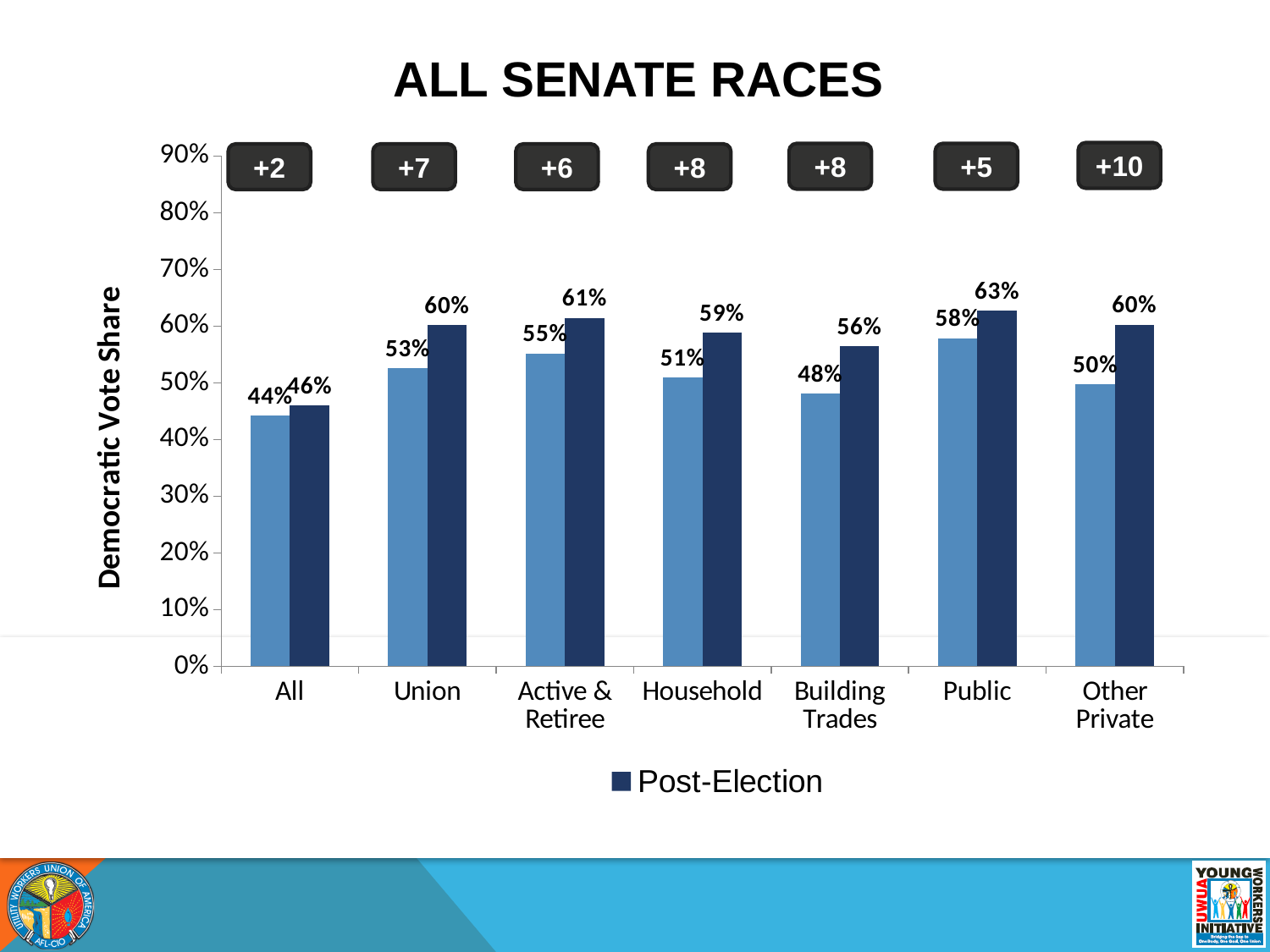
Which category has the highest Post-Election value? Public What value is shown on the lighter blue bar for Building Trades? 48% Which category has the lowest Post-Election value? All What is the title of the y axis? Democratic Vote Share What is the difference between the Post-Election values for Union and All? 14 percentage points How many series does the legend list? 1 What is the Post-Election value for Household? 59% What kind of chart is shown on the slide? Bar chart What is the Post-Election value for Public? 63% What number is shown in the dark box above the Other Private bars? +10 How many categories are shown on the x axis? 7 Which has the larger Post-Election value, Household or Building Trades? Household